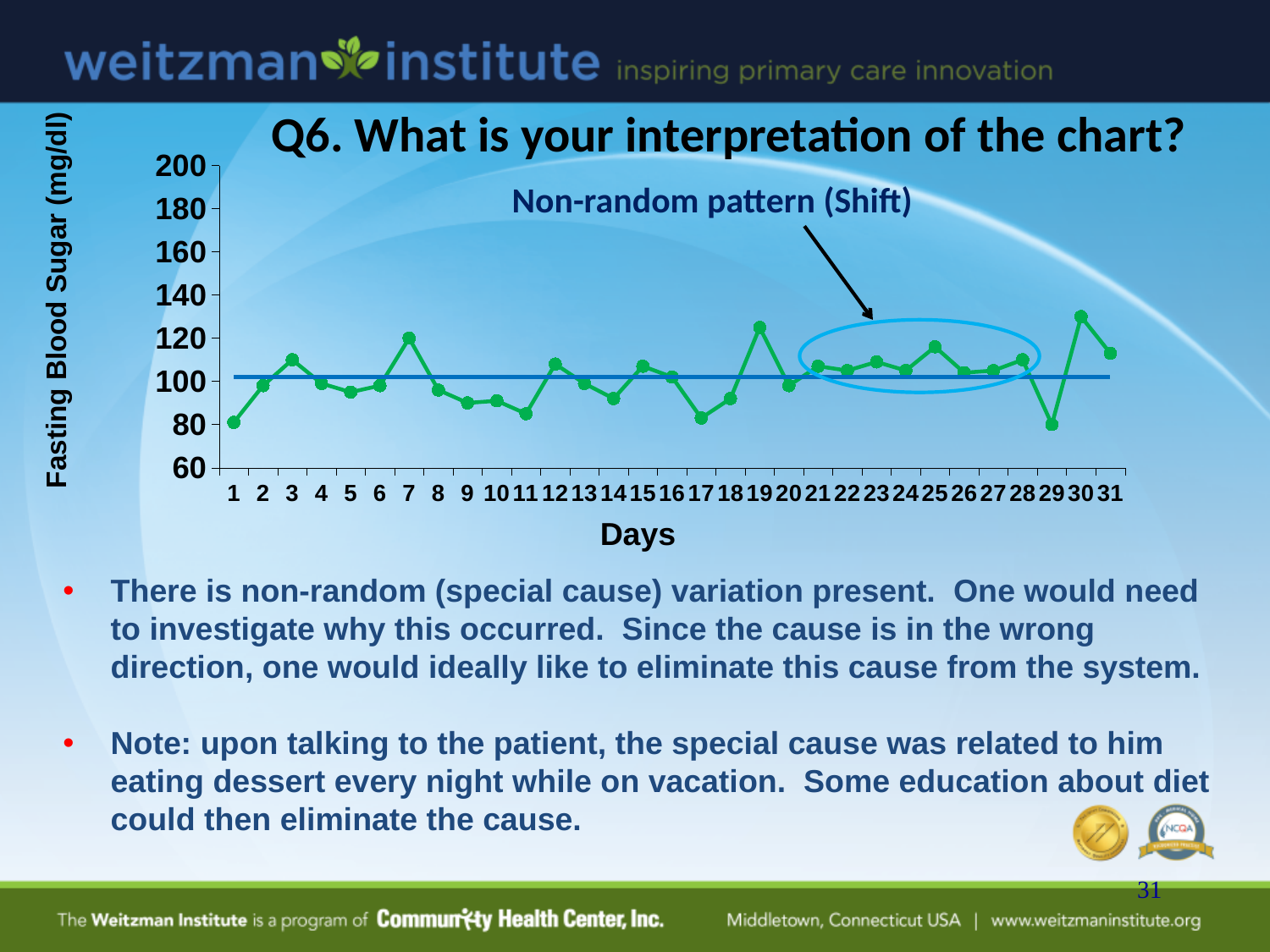
Is the fasting blood sugar value for day 7 greater or less than 100? greater What does the annotation with the arrow pointing to the circled points say? Non-random pattern (Shift) Which day has the higher fasting blood sugar value, day 7 or day 8? Day 7 Do the fasting blood sugar values rise or fall from day 1 to day 3? Rise Is the fasting blood sugar value for day 1 greater or less than 100? less Is the fasting blood sugar value for day 29 greater or less than 100? less What kind of chart is shown on the slide? Line chart How many days are plotted along the x axis of the chart? 31 What is the label on the y axis of the chart? Fasting Blood Sugar (mg/dl)